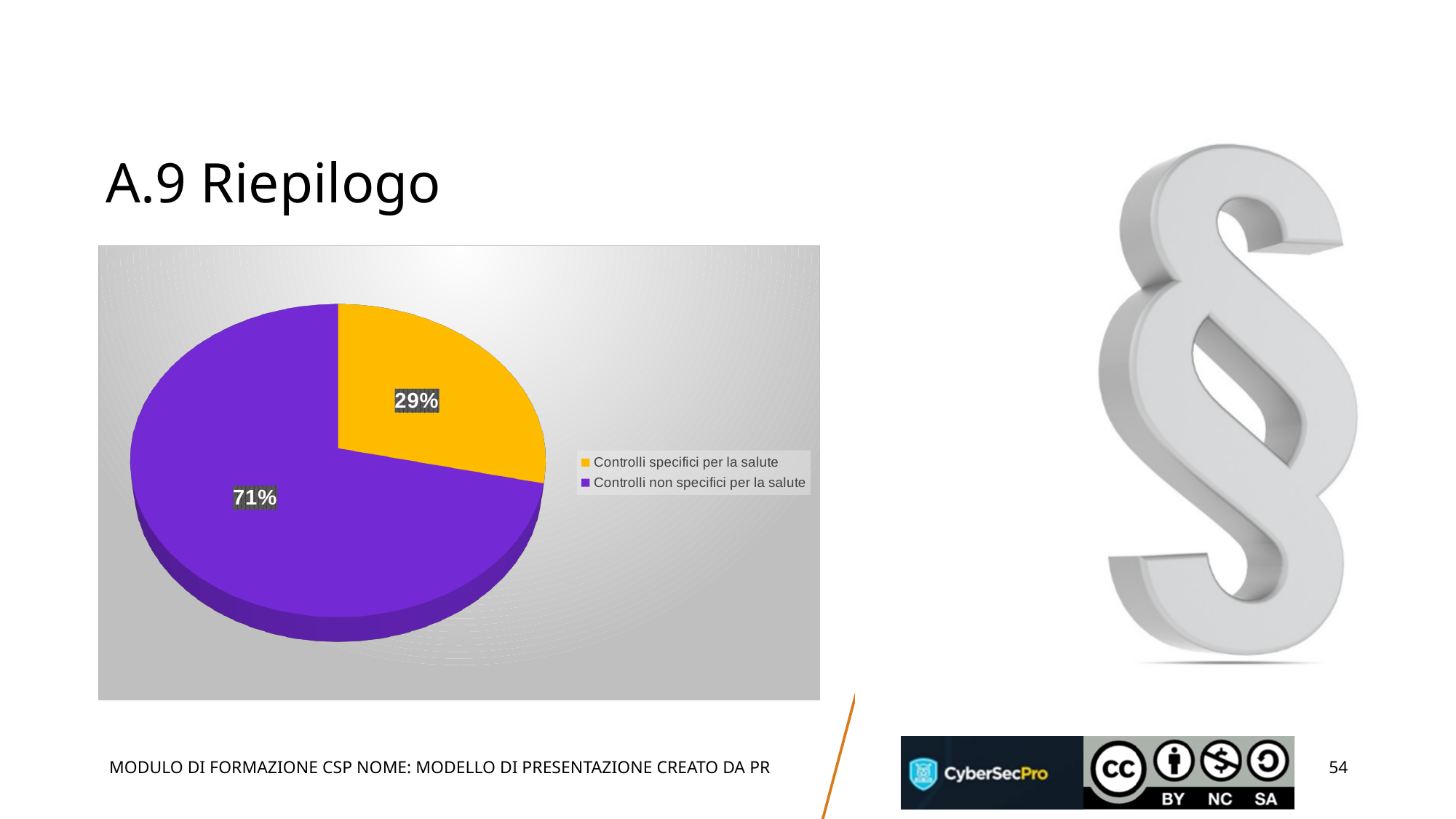
Which category has the smallest slice of the pie? Controlli specifici per la salute What kind of chart is shown on the slide? Pie chart What is the difference in percentage points between the two slices? 42 How many slices does the pie chart have? 2 How many entries does the legend list? 2 What colour is the slice for "Controlli specifici per la salute"? Yellow What share of the pie does "Controlli non specifici per la salute" represent? 71% What colour is the slice for "Controlli non specifici per la salute"? Purple What share of the pie does "Controlli specifici per la salute" represent? 29% Which is larger: the slice for "Controlli specifici per la salute" or the slice for "Controlli non specifici per la salute"? Controlli non specifici per la salute Which category has the largest slice of the pie? Controlli non specifici per la salute